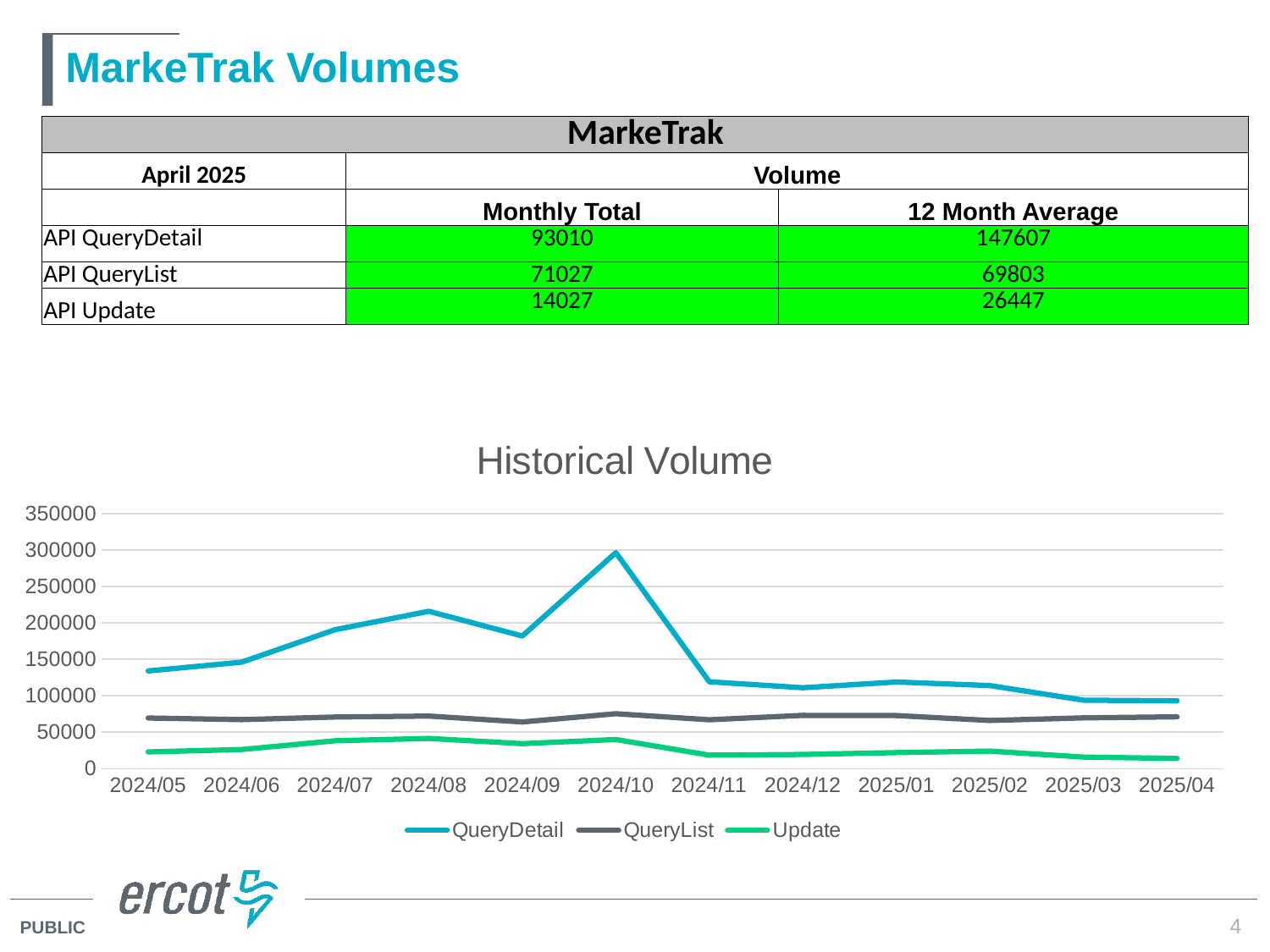
What kind of chart is the Historical Volume chart? line chart In the Historical Volume chart, is the QueryDetail value for 2024/10 greater or less than 250000? greater In the Historical Volume chart, is the Update value for 2024/10 greater or less than 50000? less In the Historical Volume chart, which series is higher at 2024/05, Update or QueryList? QueryList What is the title of the line chart on the slide? Historical Volume In the Historical Volume chart, does the QueryDetail series rise or fall from 2024/10 to 2024/11? fall In the Historical Volume chart, which series is higher at 2024/10, QueryDetail or QueryList? QueryDetail In the Historical Volume chart, is the QueryDetail value for 2024/05 greater or less than 100000? greater In the Historical Volume chart, which month has the highest QueryDetail value? 2024/10 How many months are plotted along the x axis of the Historical Volume chart? 12 How many series does the legend of the Historical Volume chart list? 3